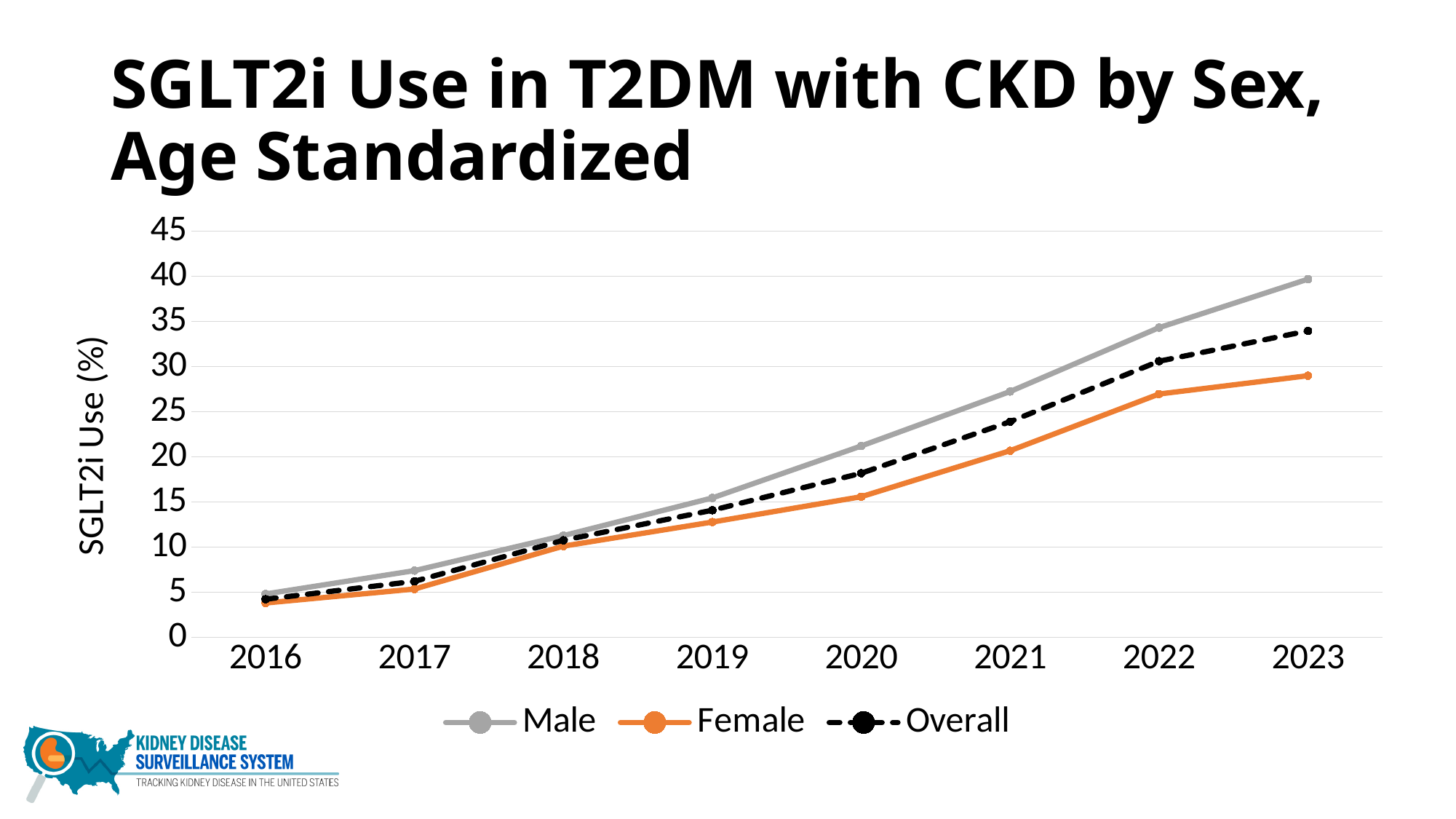
How many years are plotted along the x axis? 8 Is the value for Male in 2023 greater or less than 35? greater How many series does the legend list? 3 Which series has the lowest value in 2023? Female Do the values for the Male series rise or fall from 2016 to 2023? rise Is the value for Female in 2020 greater or less than 20? less Which is larger in 2022, the Overall value or the Female value? Overall Which series has the highest value in 2023? Male In which year is the Female series at its lowest? 2016 Is the value for Female in 2023 greater or less than 30? less In which year is the Male series at its highest? 2023 What kind of chart is shown on the slide? line chart